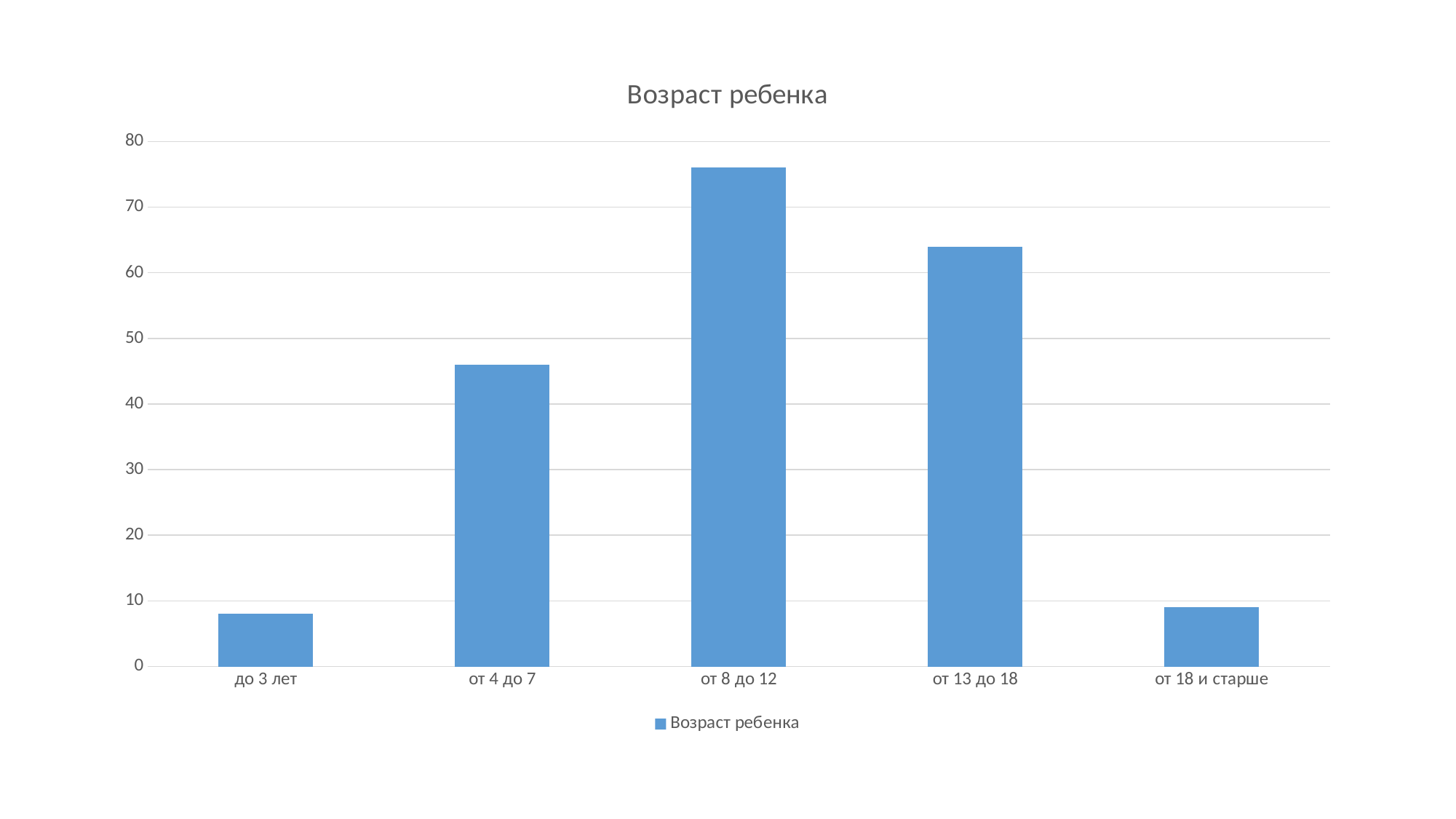
Is the value for от 13 до 18 greater or less than 60? greater Which is larger, the value for от 8 до 12 or the value for от 13 до 18? от 8 до 12 Is the value for от 4 до 7 greater or less than 50? less What kind of chart is shown on the slide? bar chart Which category has the highest bar? от 8 до 12 Is the value for до 3 лет greater or less than 10? less Which is larger, the value for от 4 до 7 or the value for от 13 до 18? от 13 до 18 How many series does the legend list? 1 How many categories are shown on the x axis? 5 What is the title of the chart? Возраст ребенка